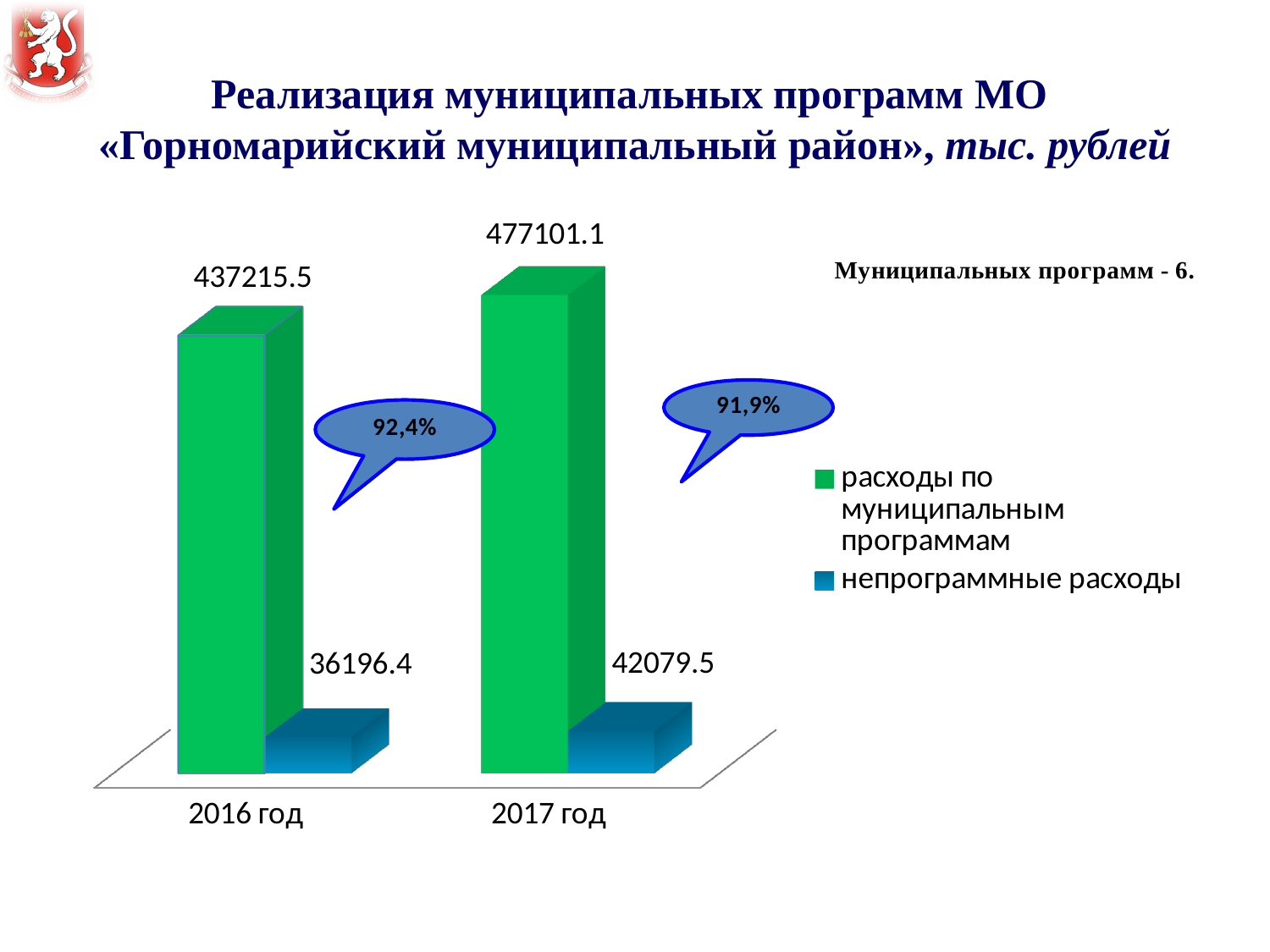
What is the value for расходы по муниципальным программам in 2016 год? 437215.5 What percentage is shown in the callout next to the 2017 год bars? 91,9% What is the value for расходы по муниципальным программам in 2017 год? 477101.1 What is the difference between непрограммные расходы in 2017 год and 2016 год? 5883.1 Which is larger in 2017 год: расходы по муниципальным программам or непрограммные расходы? расходы по муниципальным программам By how much did расходы по муниципальным программам increase from 2016 год to 2017 год? 39885.6 In which year are непрограммные расходы lowest? 2016 год What is the value for непрограммные расходы in 2016 год? 36196.4 In which year are расходы по муниципальным программам highest? 2017 год How many series does the legend list? 2 What is the value for непрограммные расходы in 2017 год? 42079.5 What kind of chart is shown on the slide? bar chart